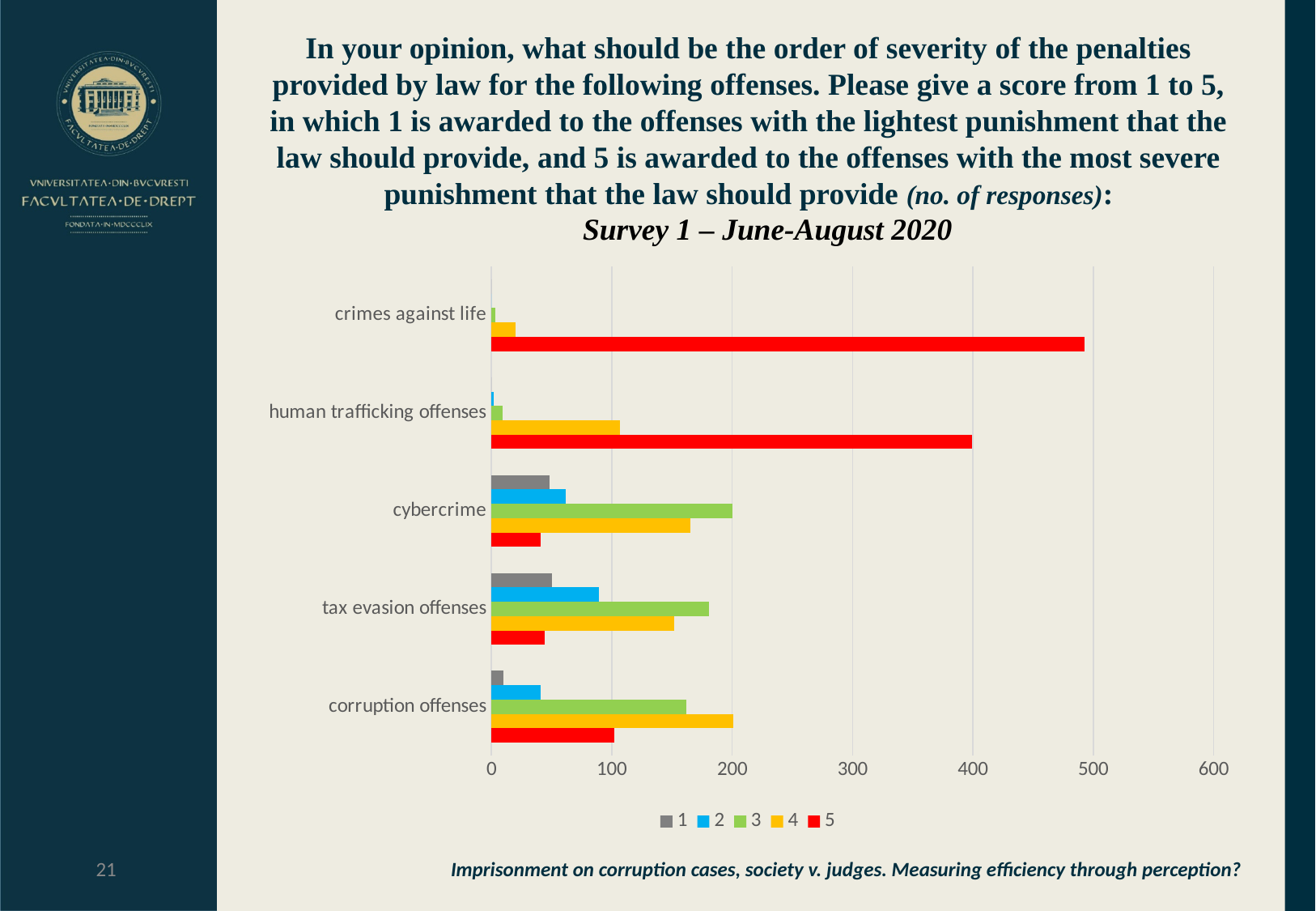
What kind of chart is shown on the slide? bar chart Which survey period is named in the chart title? Survey 1 – June-August 2020 Which offense category has the longest bar for score 5? crimes against life For tax evasion offenses, which score has the longest bar? 3 How many series does the legend list? 5 Is the score 5 value for crimes against life greater or less than 400? greater Which is larger: the score 5 value for crimes against life or the score 5 value for human trafficking offenses? crimes against life Is the score 3 value for tax evasion offenses greater or less than 200? less For corruption offenses, which score has the longest bar? 4 How many offense categories are plotted on the chart? 5 Is the score 1 value for cybercrime greater or less than 100? less